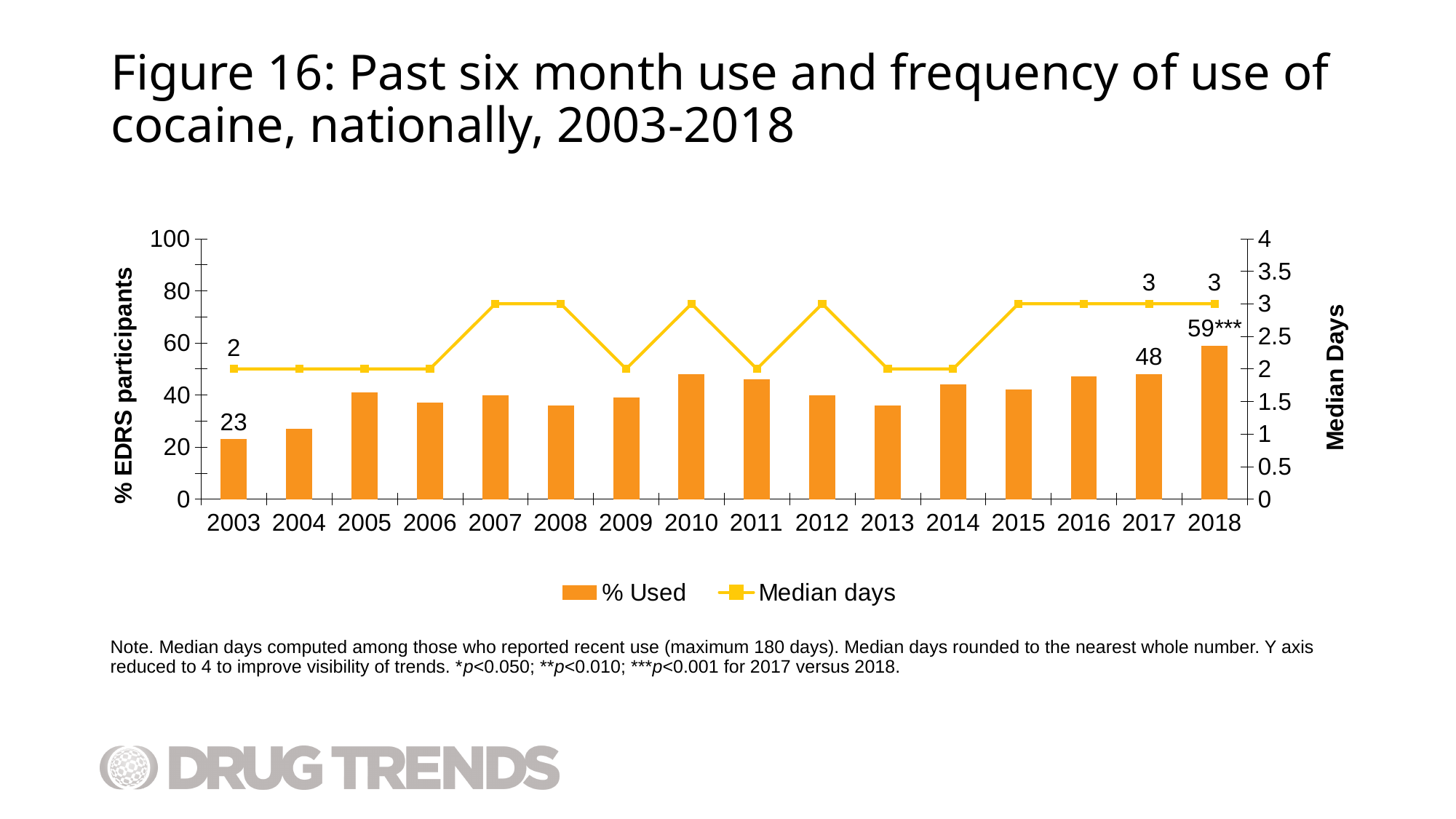
How many years are shown on the x axis? 16 What is the Median days value for 2003? 2 What is the difference in % Used between 2018 and 2017? 11 What is the % Used value for 2018? 59 Is the % Used value for 2004 greater or less than 40? less Which year has the highest % Used bar? 2018 Is the % Used value for 2010 greater or less than 40? greater How many series does the legend list? 2 What is the % Used value for 2017? 48 What is the Median days value for 2010? 3 What is the % Used value for 2003? 23 Which year has the lowest % Used bar? 2003